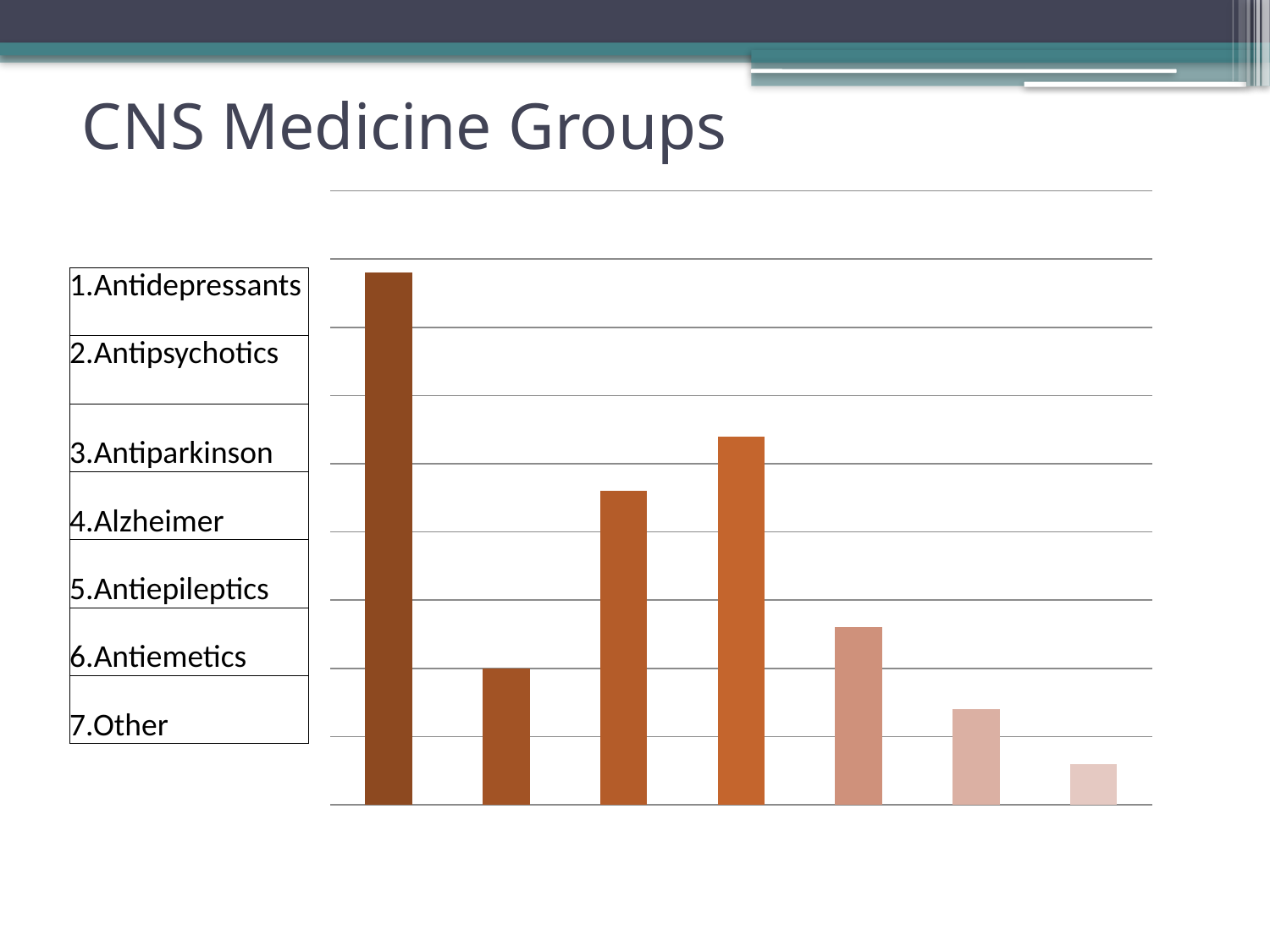
How many bars does the chart contain? 7 How many medicine groups are listed in the table beside the chart? 7 Which medicine group is listed first in the table beside the chart? Antidepressants Which is taller, the fourth bar or the fifth bar from the left? the fourth bar What is the title of the slide containing the chart? CNS Medicine Groups Which is taller, the sixth bar or the seventh bar from the left? the sixth bar Which bar is the tallest in the chart, counting from the left? the first bar Which is taller, the second bar or the third bar from the left? the third bar Do the bar heights fall from the fourth bar through to the seventh bar? Yes What kind of chart is shown on the slide? bar chart Do the bar heights fall steadily from left to right across the chart? No Which bar is the shortest in the chart, counting from the left? the seventh (last) bar